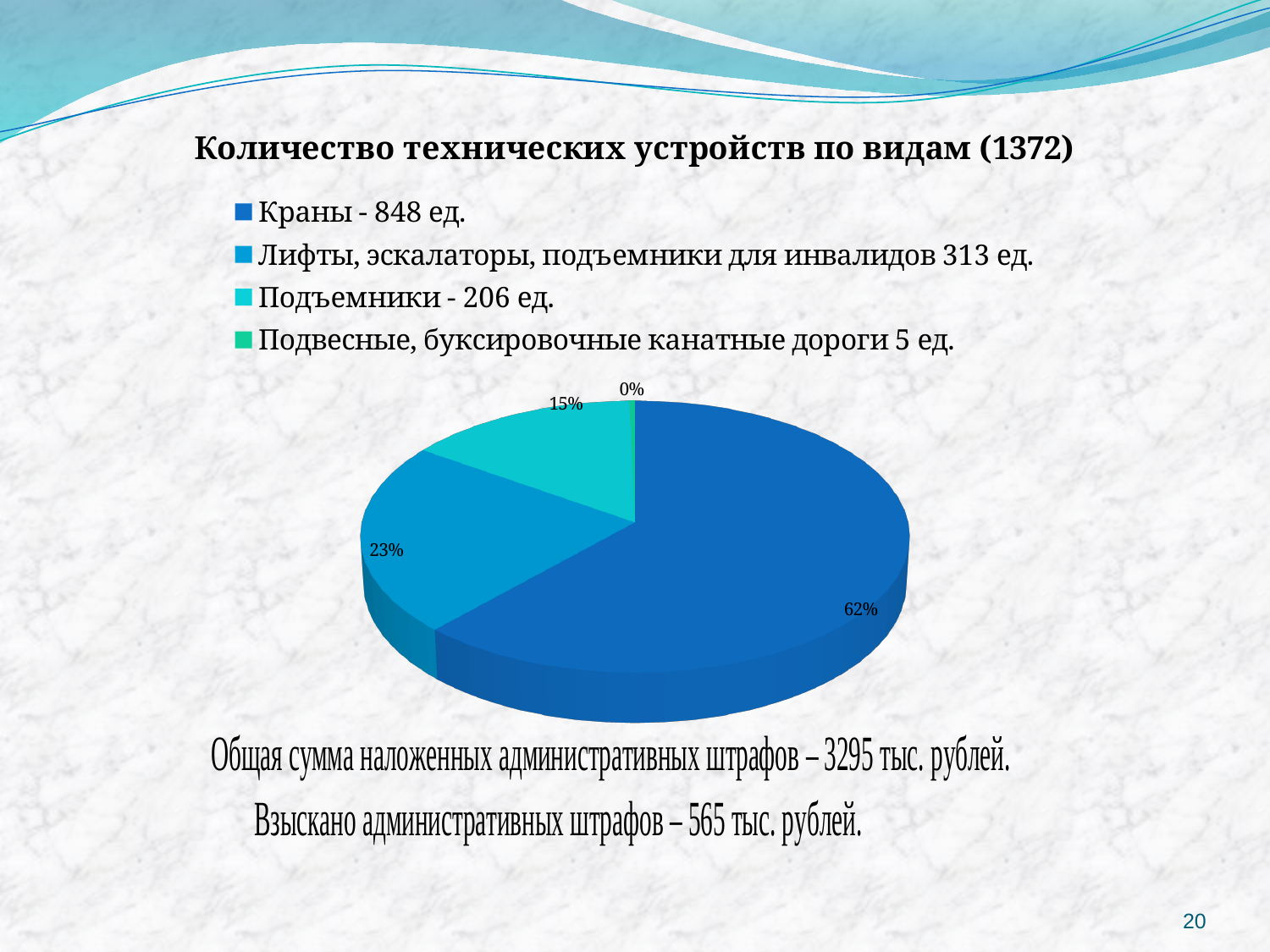
What is the difference in percentage points between the Краны slice and the Подъемники slice? 47 What kind of chart is shown on the slide? pie chart How many slices does the pie chart have? 4 Which category has the smallest slice of the pie? Подвесные, буксировочные канатные дороги What share of the pie does Лифты, эскалаторы, подъемники для инвалидов take? 23% What is the title of the chart? Количество технических устройств по видам (1372) How many entries does the legend list? 4 What share of the pie does Краны take? 62% What share of the pie does Подвесные, буксировочные канатные дороги take? 0% Which category has the largest slice of the pie? Краны Which slice is larger: Лифты, эскалаторы, подъемники для инвалидов or Подъемники? Лифты, эскалаторы, подъемники для инвалидов